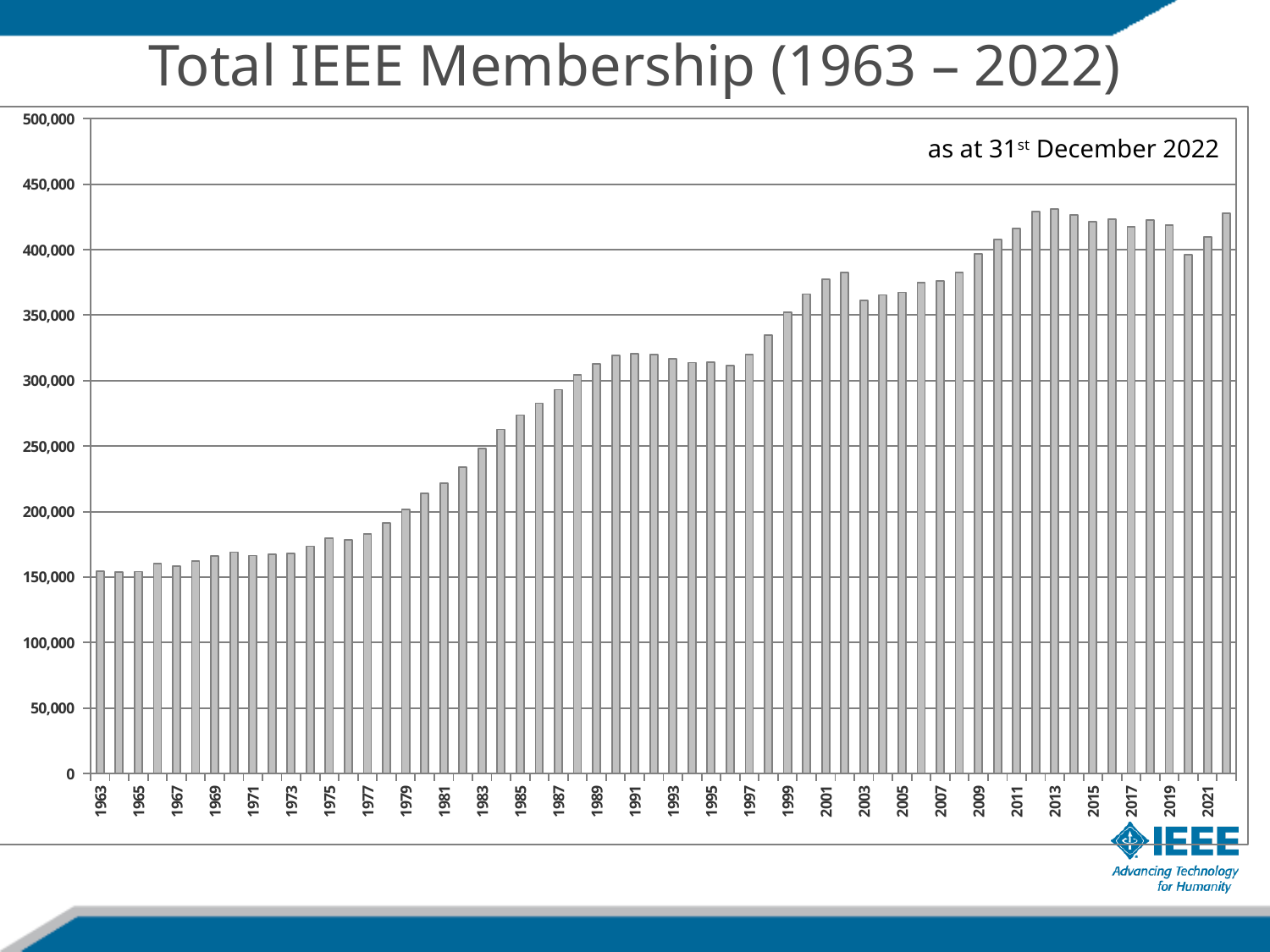
Is the value for 1963 greater or less than 200,000? less Which year has the larger value, 1981 or 1991? 1991 Is the value for 1997 greater or less than 350,000? less Is the value for 1985 greater or less than 250,000? greater Overall, do the values rise or fall from 1963 to 2022? rise What date is the membership data stated to be as at, according to the note on the chart? 31st December 2022 What kind of chart is shown on the slide? bar chart Which year has the larger value, 2001 or 2005? 2001 What is the title of the chart? Total IEEE Membership (1963 – 2022)